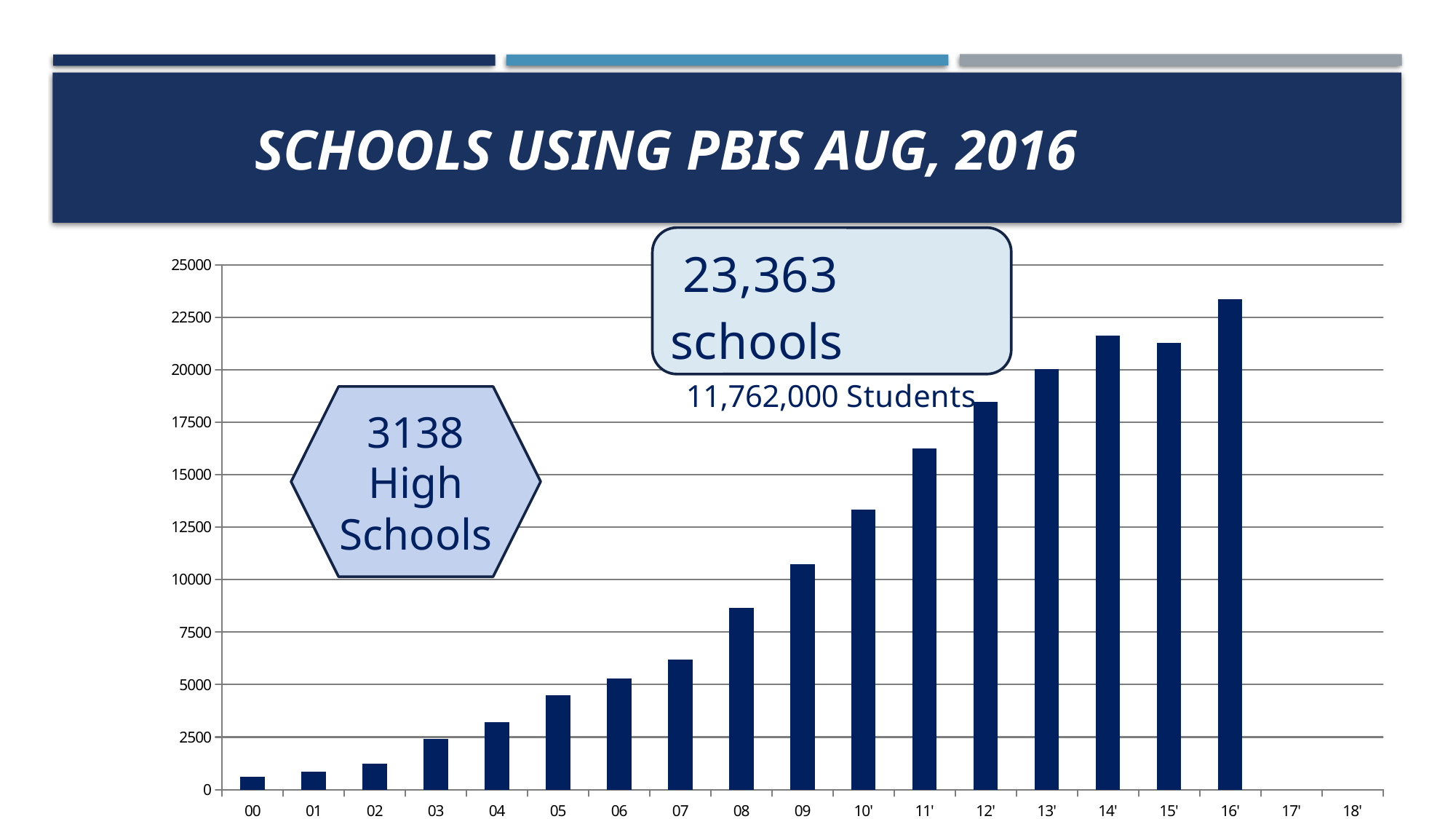
Do the values generally rise or fall from 00 to 16'? rise Is the value for 05 greater or less than 5000? less How many bars are plotted on the chart? 17 Is the value for 10' greater or less than 12500? greater Is the value for 12' greater or less than 17500? greater What is the title of the slide? SCHOOLS USING PBIS AUG, 2016 What kind of chart is shown on the slide? bar chart How many schools does the callout box on the chart state? 23,363 schools Which year has the shortest bar? 00 Which year has the tallest bar? 16' Which is larger, the value for 11' or the value for 12'? 12'